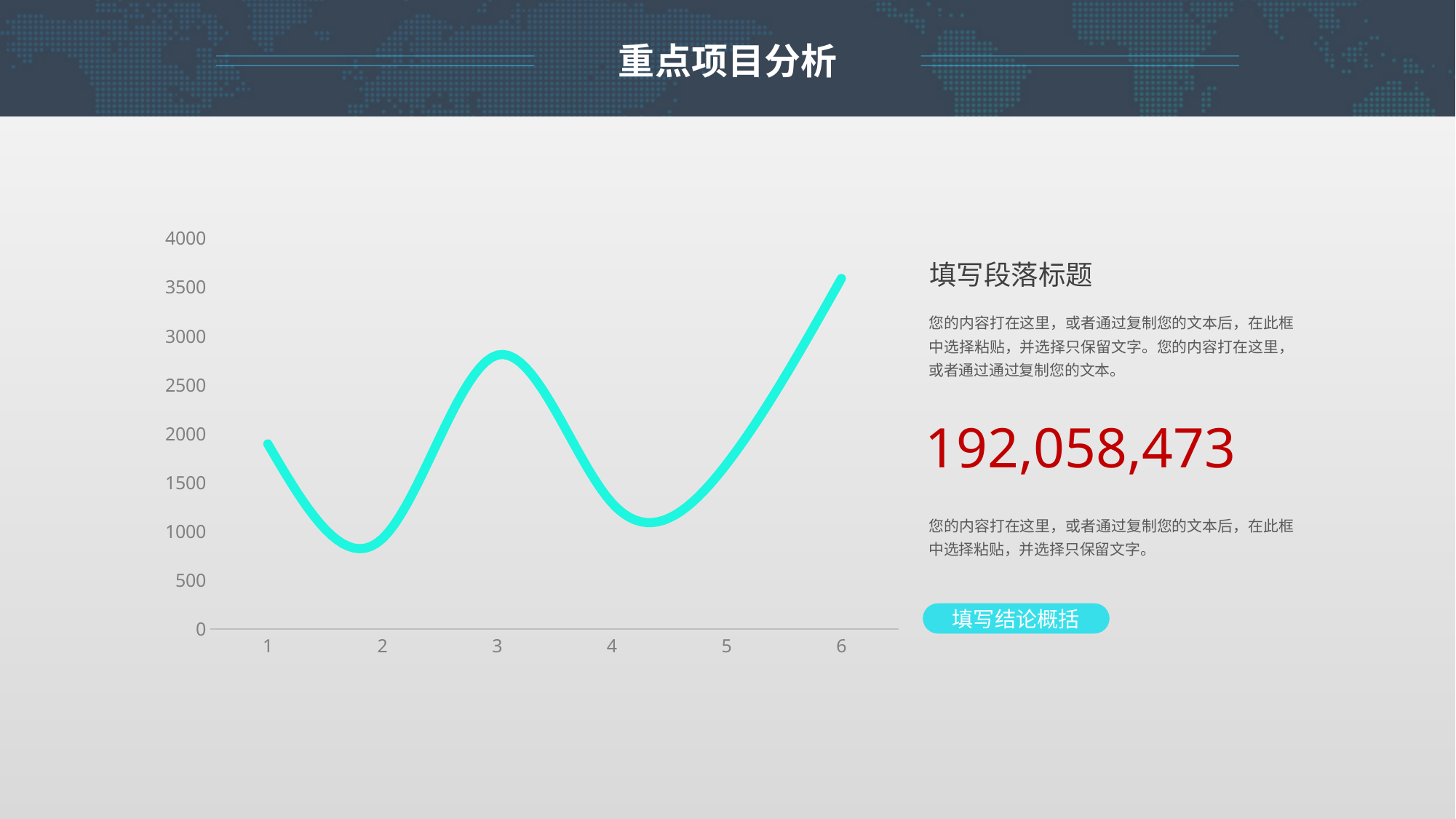
Is the value at x = 4 greater or less than 1500? less What kind of chart is shown on the slide? line chart What is the title shown at the top of the slide? 重点项目分析 Is the value at x = 1 greater or less than 1500? greater Is the value at x = 3 greater or less than 2500? greater At which x-axis category does the line reach its highest value? 6 How many points are plotted along the x axis of the line chart? 6 Which has the larger value, x = 1 or x = 6? 6 At which x-axis category does the line reach its lowest value? 2 Which has the larger value, x = 3 or x = 4? 3